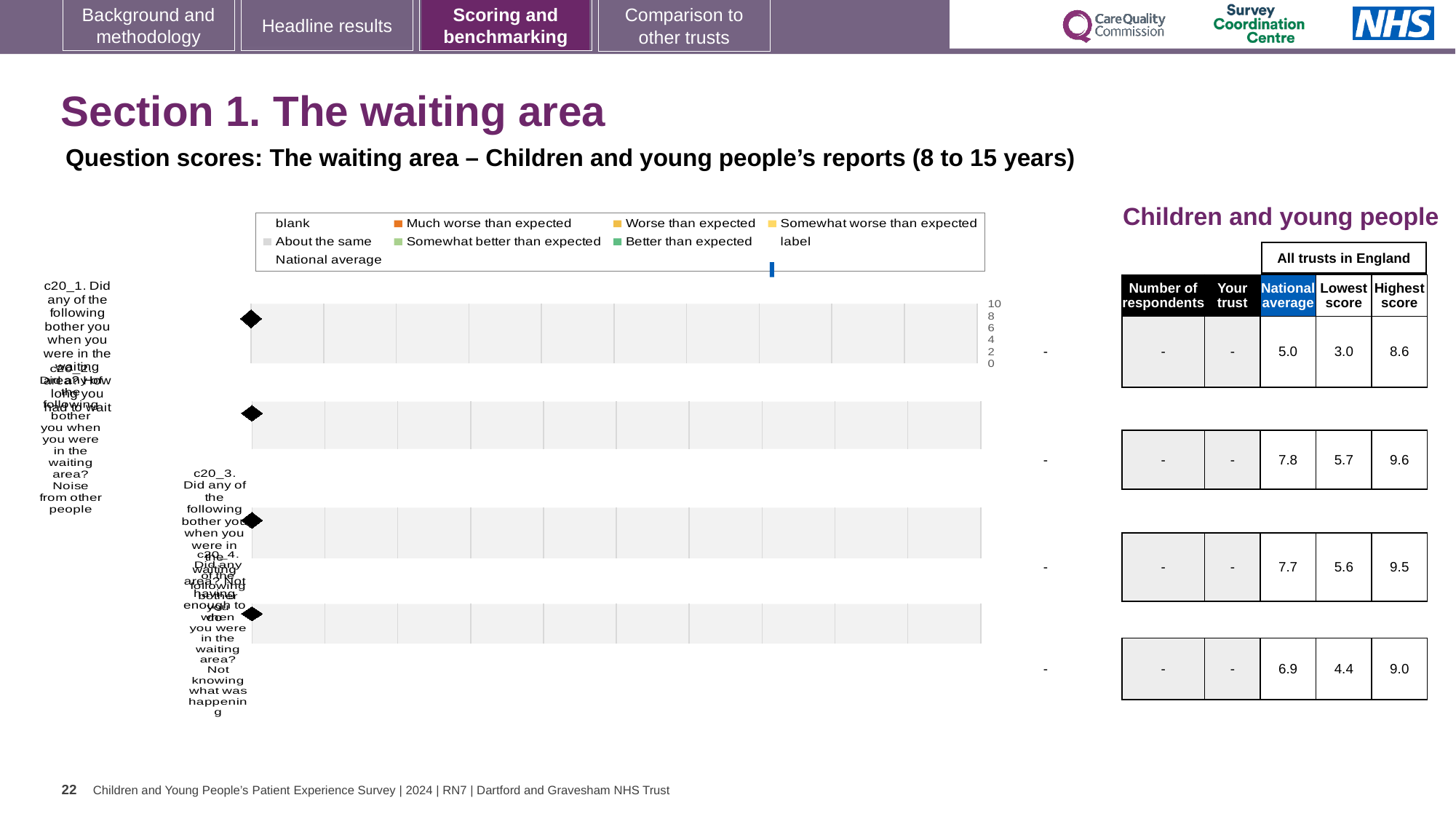
Which row of the table has the lowest national average? c20_1 (5.0) What kind of chart is shown on the slide? bar chart In the table beside the chart, what is the lowest score for the fourth row (c20_4)? 4.4 How many entries does the chart legend list? 9 In the table beside the chart, what is the national average for the first row (c20_1)? 5.0 In the table beside the chart, what is the highest score for the second row (c20_2)? 9.6 What colour is the legend marker for 'Much worse than expected'? orange In the table, what is the difference between the highest score and the lowest score for the third row (c20_3)? 3.9 Which row of the table has the highest national average? c20_2 (7.8) What colour is the legend marker for 'Better than expected'? green In the table, which has the larger national average: the third row (c20_3) or the fourth row (c20_4)? c20_3 How many question categories (c20_1 to c20_4) are plotted on the chart? 4